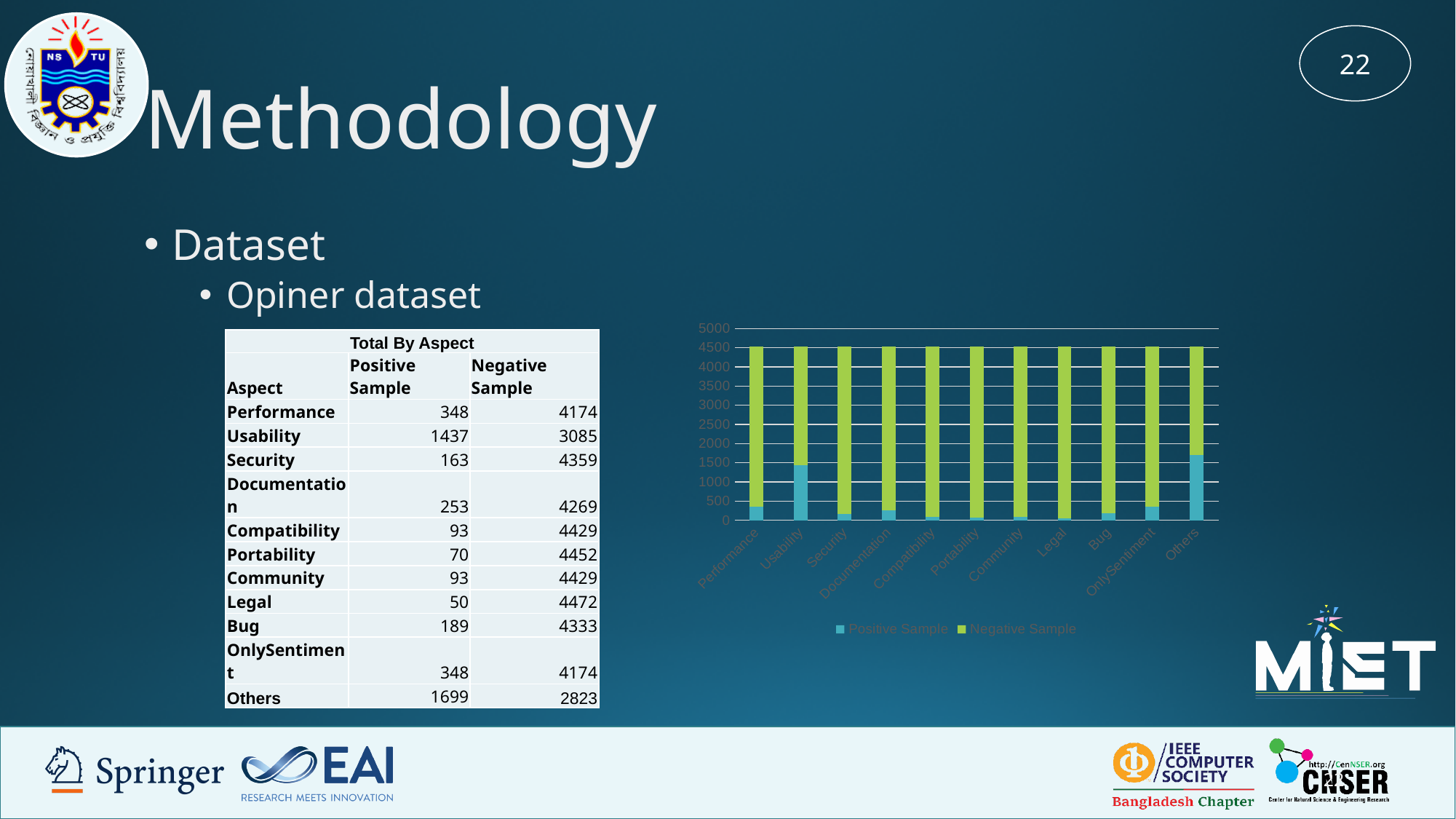
Is the Positive Sample value for Usability greater or less than 1000? greater What are the two legend entries of the chart? Positive Sample, Negative Sample How many aspect categories are plotted along the x axis of the chart? 11 What is the total of the stacked bar for Usability (Positive Sample plus Negative Sample)? 4522 Is the Positive Sample value for Others greater or less than 1500? greater How many series does the chart legend list? 2 What kind of chart is shown on the slide? stacked bar chart Is the Positive Sample value for Performance greater or less than 500? less Which aspect has the tallest Positive Sample segment in the chart? Others Which has the larger Positive Sample segment in the chart, Usability or Security? Usability What is the Positive Sample value for Legal? 50 What is the Negative Sample value for Security? 4359